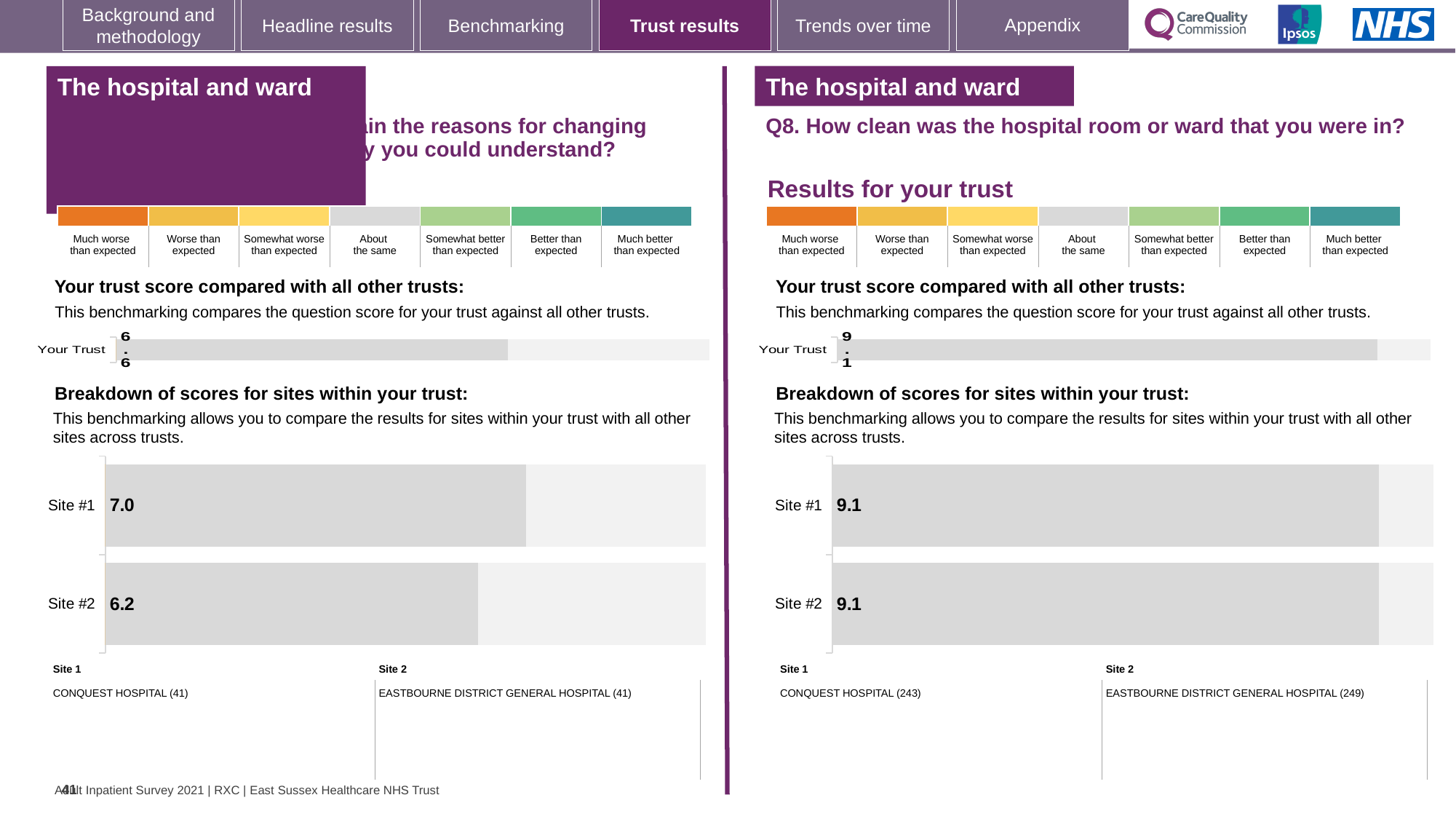
On the left-hand site breakdown chart, what is the difference between the Site #1 and Site #2 scores? 0.8 On the right-hand chart for Q8, what is the score for Site #2? 9.1 On the left-hand site breakdown chart, which site has the higher score? Site #1 On the right-hand site breakdown chart for Q8, what is the difference between the Site #1 and Site #2 scores? 0.0 On the left-hand 'Your trust score compared with all other trusts' chart, what is the score shown for Your Trust? 6.6 On the right-hand chart for Q8 (How clean was the hospital room or ward that you were in?), what is the score for Site #1? 9.1 On the left-hand site breakdown chart, what is the score for Site #1? 7.0 On the right-hand 'Your trust score compared with all other trusts' chart for Q8, what is the score shown for Your Trust? 9.1 On the left-hand site breakdown chart, what is the score for Site #2? 6.2 How many sites are shown in the left-hand site breakdown chart? 2 What type of chart is used for the site breakdown on the right-hand side of the slide? Bar chart On the right-hand side of the slide, which hospital is listed as Site 2? EASTBOURNE DISTRICT GENERAL HOSPITAL (249)